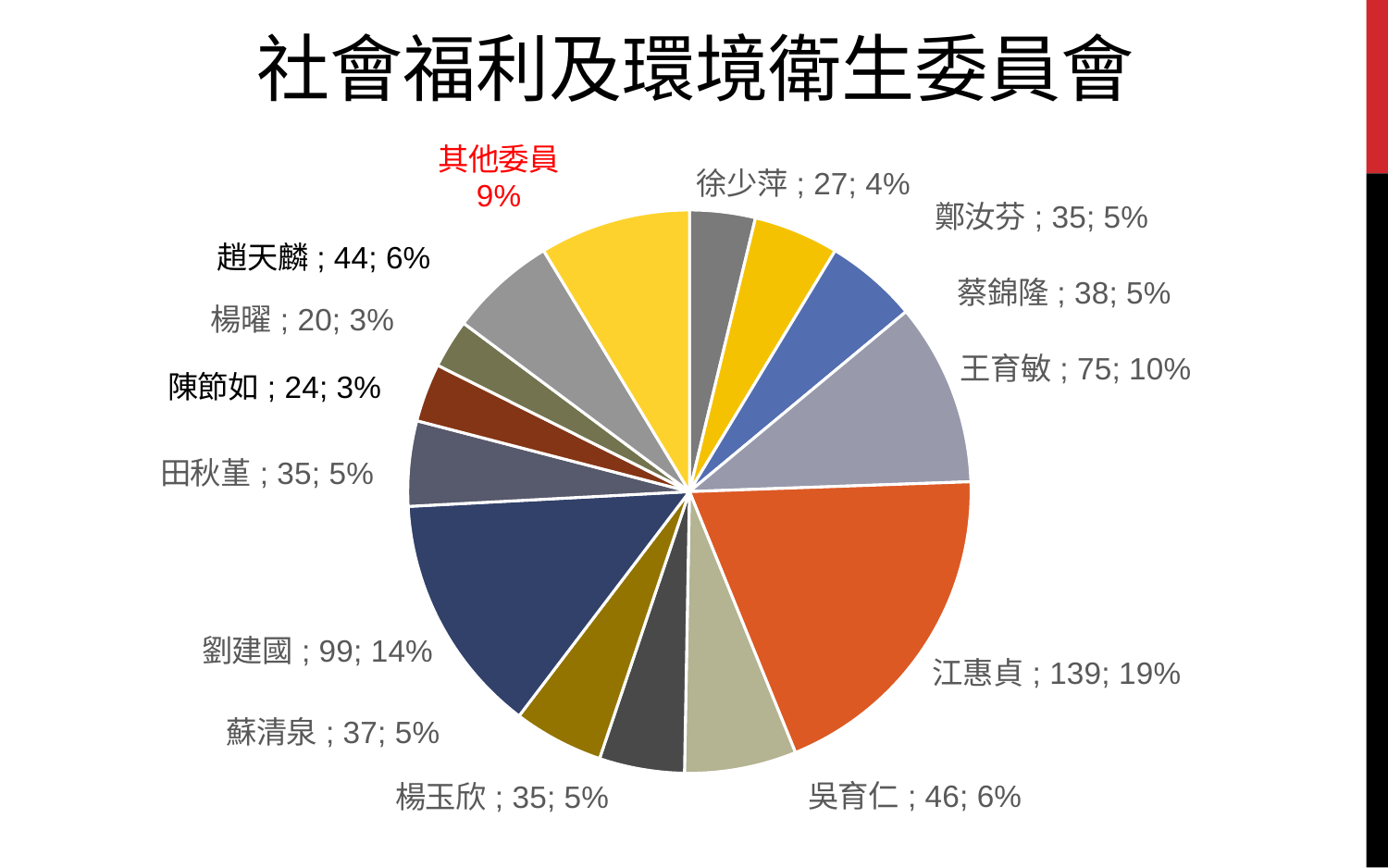
What share of the pie does 劉建國 represent? 14% What is the value for 劉建國? 99 What share of the pie does 其他委員 represent? 9% What is the value for 江惠貞? 139 Which is larger, the value for 吳育仁 or the value for 趙天麟? 吳育仁 What is the value for 王育敏? 75 What is the difference between the values for 江惠貞 and 劉建國? 40 How many slices does the pie chart have? 14 What is the title of the chart? 社會福利及環境衛生委員會 Which category has the largest slice of the pie? 江惠貞 Which category has the smallest slice of the pie? 楊曜 What kind of chart is shown on the slide? pie chart